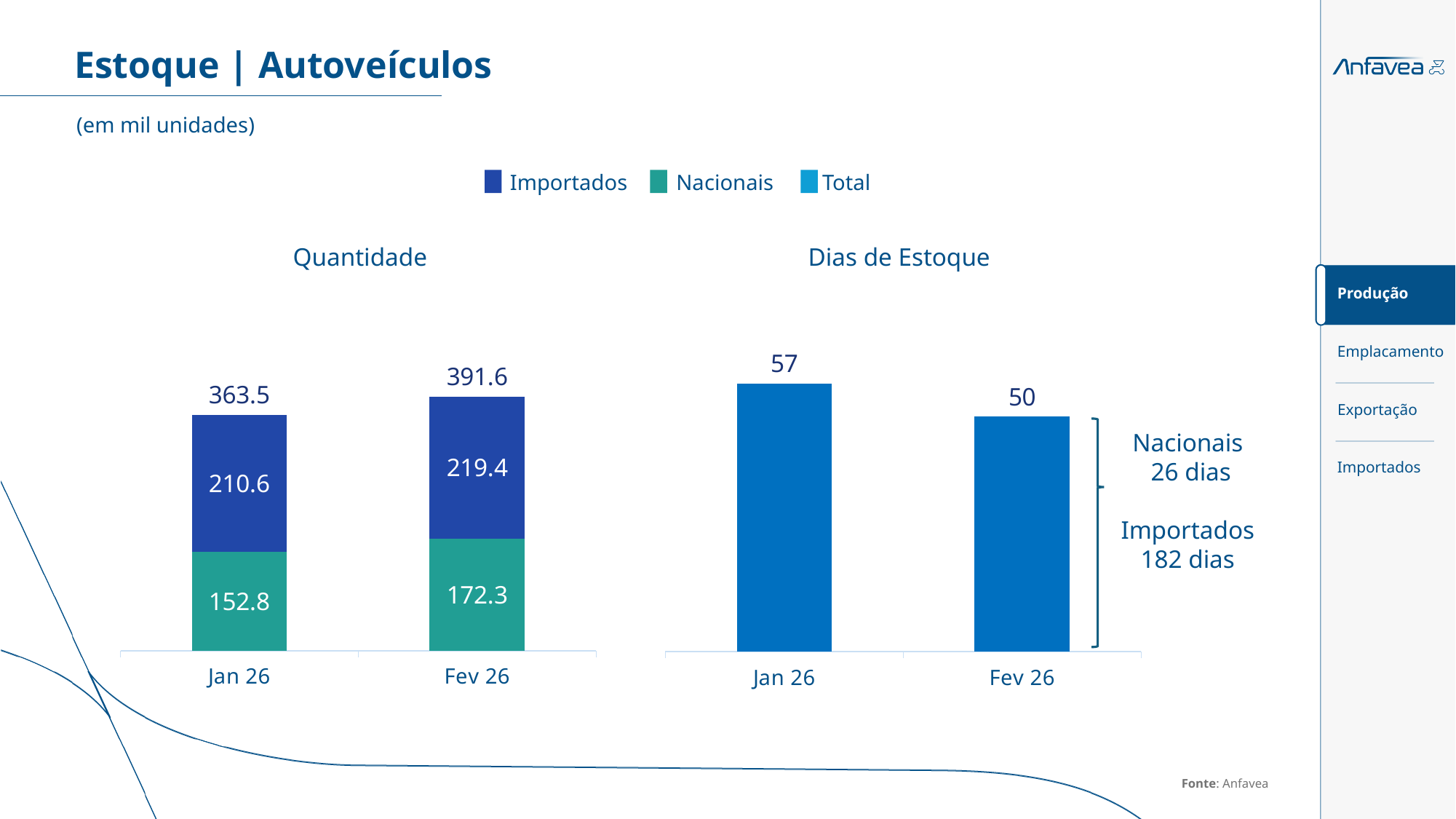
In the Dias de Estoque chart, which month has the lowest value? Fev 26 In the Quantidade chart, what is the total of the stacked bar for Fev 26? 391.6 What kind of chart is the Quantidade chart? stacked bar chart In the Quantidade chart, what is the total of the stacked bar for Jan 26? 363.5 In the Quantidade chart, what is the difference between the Nacionais values for Fev 26 and Jan 26? 19.5 In the Quantidade chart, what is the value for Importados in Fev 26? 219.4 In the Dias de Estoque chart, do the values rise or fall from Jan 26 to Fev 26? fall In the Dias de Estoque chart, what is the difference between Jan 26 and Fev 26? 7 In the Quantidade chart, which is larger in Jan 26, Importados or Nacionais? Importados In the Dias de Estoque chart, what is the value for Jan 26? 57 In the Quantidade chart, what is the value for Nacionais in Jan 26? 152.8 How many entries does the legend list? 3